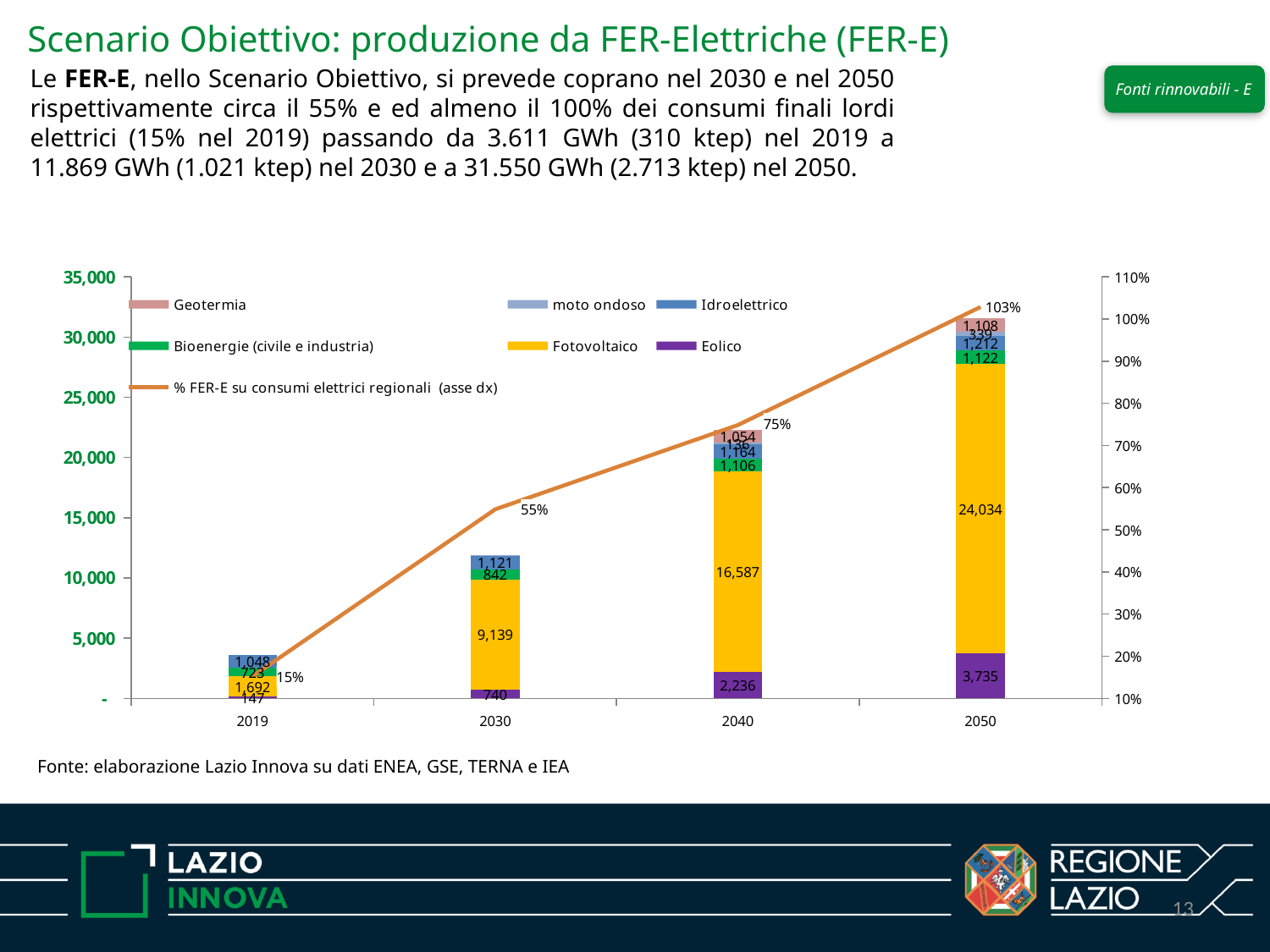
Is the total height of the stacked bar for 2050 greater or less than 30,000? greater What is the value of the % FER-E su consumi elettrici regionali line for 2030? 55% In which year is the Fotovoltaico value highest? 2050 How many series does the legend list? 7 What is the difference between the Eolico values for 2050 and 2040? 1,499 What is the Fotovoltaico value for 2050? 24,034 Does the % FER-E su consumi elettrici regionali line rise or fall from 2019 to 2050? rise What is the value of the % FER-E su consumi elettrici regionali line for 2050? 103% Which is larger in 2050, the Eolico value or the Bioenergie (civile e industria) value? Eolico What is the difference between the Fotovoltaico values for 2050 and 2019? 22,342 How many years are shown on the x axis? 4 What is the Eolico value for 2040? 2,236